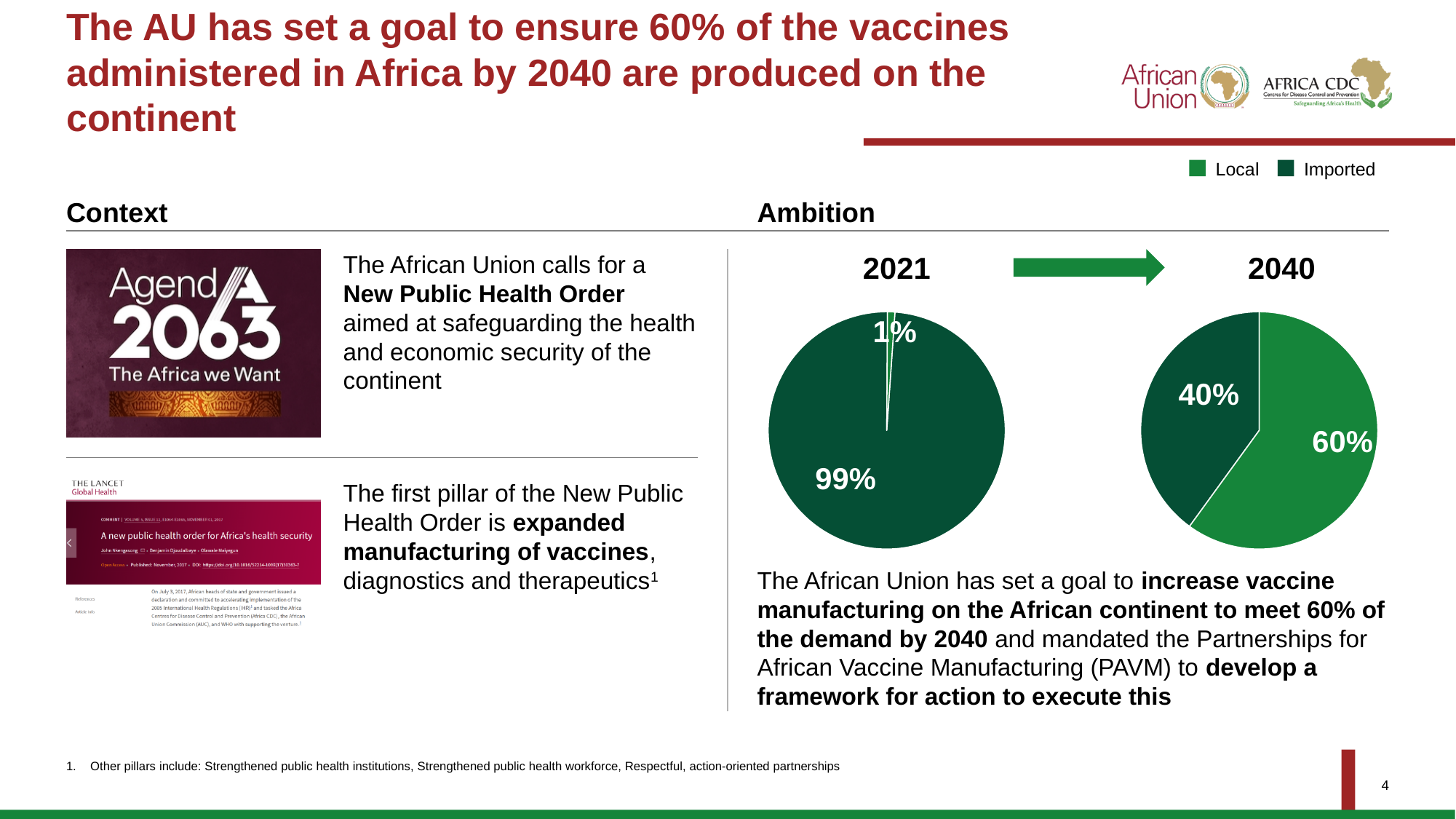
In the 2021 pie chart, what share of vaccines is Imported? 99% How many series does the legend above the pie charts list? 2 In the 2040 pie chart, what share of vaccines is Imported? 40% In the 2040 pie chart, which slice is the smallest? Imported In the 2021 pie chart, what share of vaccines is Local? 1% In the 2040 pie chart, which slice is larger, Local or Imported? Local How many slices does the 2040 pie chart have? 2 What is the difference between the Local share in the 2040 pie chart and the Local share in the 2021 pie chart? 59 percentage points In the 2040 pie chart, what share of vaccines is Local? 60% Which colour represents Imported in the pie charts' legend? Dark green What type of chart is used to show the 2021 and 2040 vaccine shares? Pie chart In the 2021 pie chart, which slice is the largest? Imported